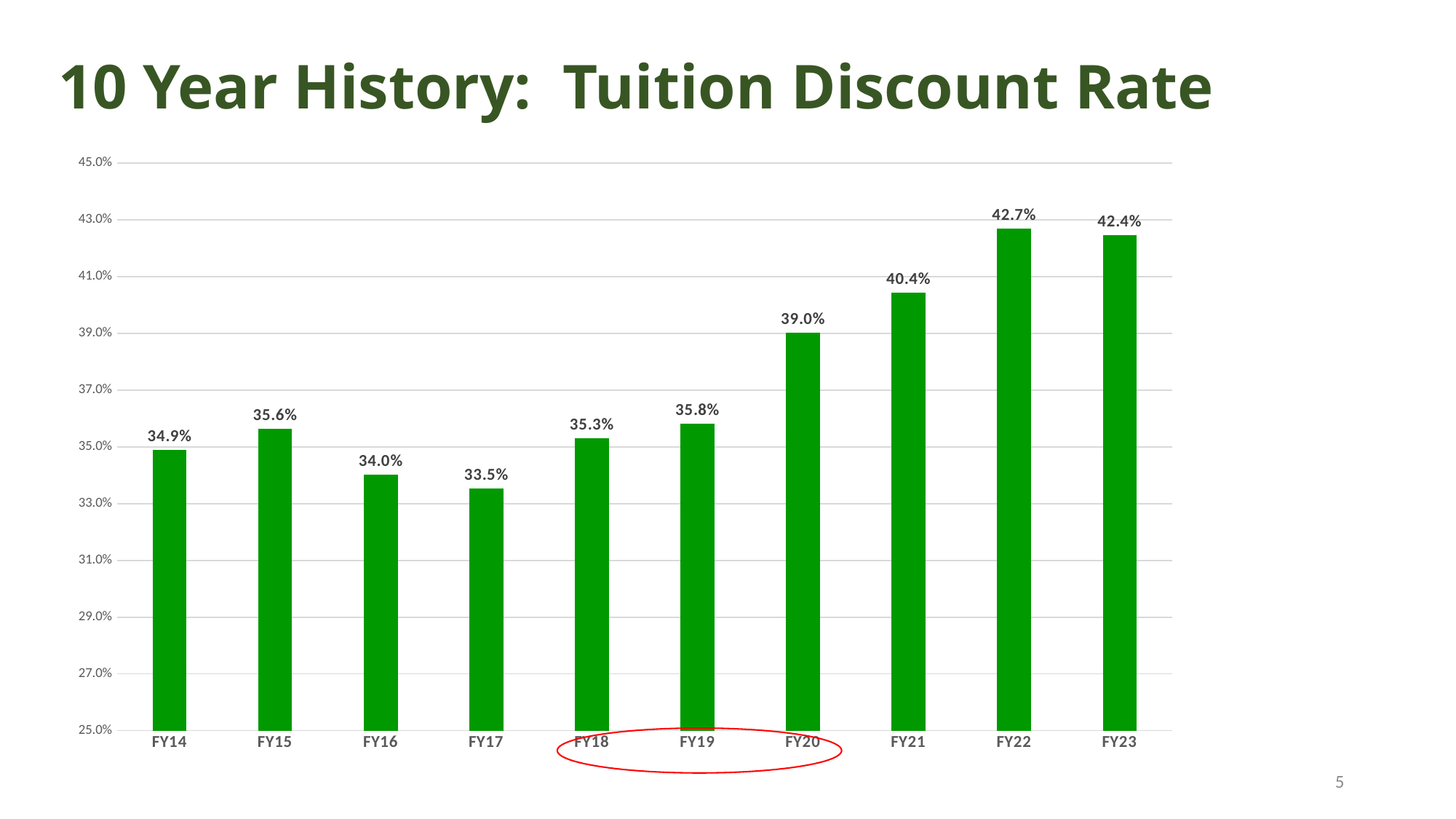
Which is larger, the tuition discount rate in FY15 or FY16? FY15 Which fiscal year has the highest tuition discount rate? FY22 What kind of chart is shown on the slide? bar chart Which fiscal year has the lowest tuition discount rate? FY17 What is the tuition discount rate for FY20? 39.0% How many fiscal years are shown on the chart? 10 What is the difference between the tuition discount rate in FY23 and FY14? 7.5% What is the tuition discount rate for FY14? 34.9% Is the tuition discount rate for FY19 greater or less than 37.0%? less Does the tuition discount rate rise or fall from FY17 to FY22? rise Which fiscal years are circled in red on the chart? FY18, FY19, FY20 What is the difference between the tuition discount rate in FY21 and FY20? 1.4%